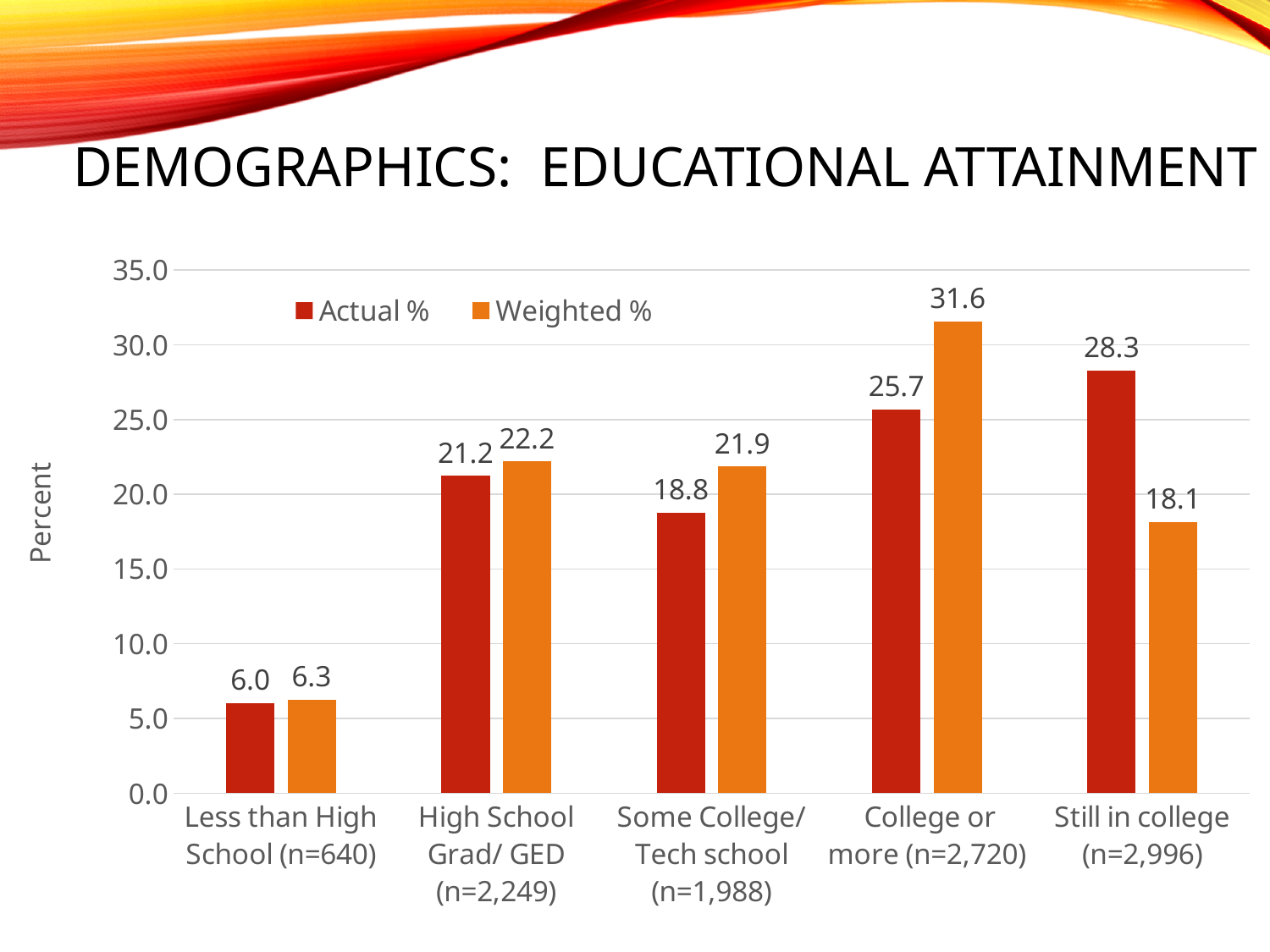
Which is larger for Some College/ Tech school (n=1,988): the Actual % or the Weighted % value? Weighted % Which category has the highest Weighted % value? College or more (n=2,720) Which category has the lowest Actual % value? Less than High School (n=640) What is the difference between the Weighted % and Actual % values for College or more (n=2,720)? 5.9 Is the Actual % value for Still in college (n=2,996) greater or less than 25.0? greater What is the difference between the Actual % and Weighted % values for Still in college (n=2,996)? 10.2 How many education categories are shown on the x axis? 5 What kind of chart is shown on the slide? Bar chart How many series does the legend list? 2 What is the Weighted % value for Less than High School (n=640)? 6.3 What is the Weighted % value for Still in college (n=2,996)? 18.1 What is the Actual % value for College or more (n=2,720)? 25.7